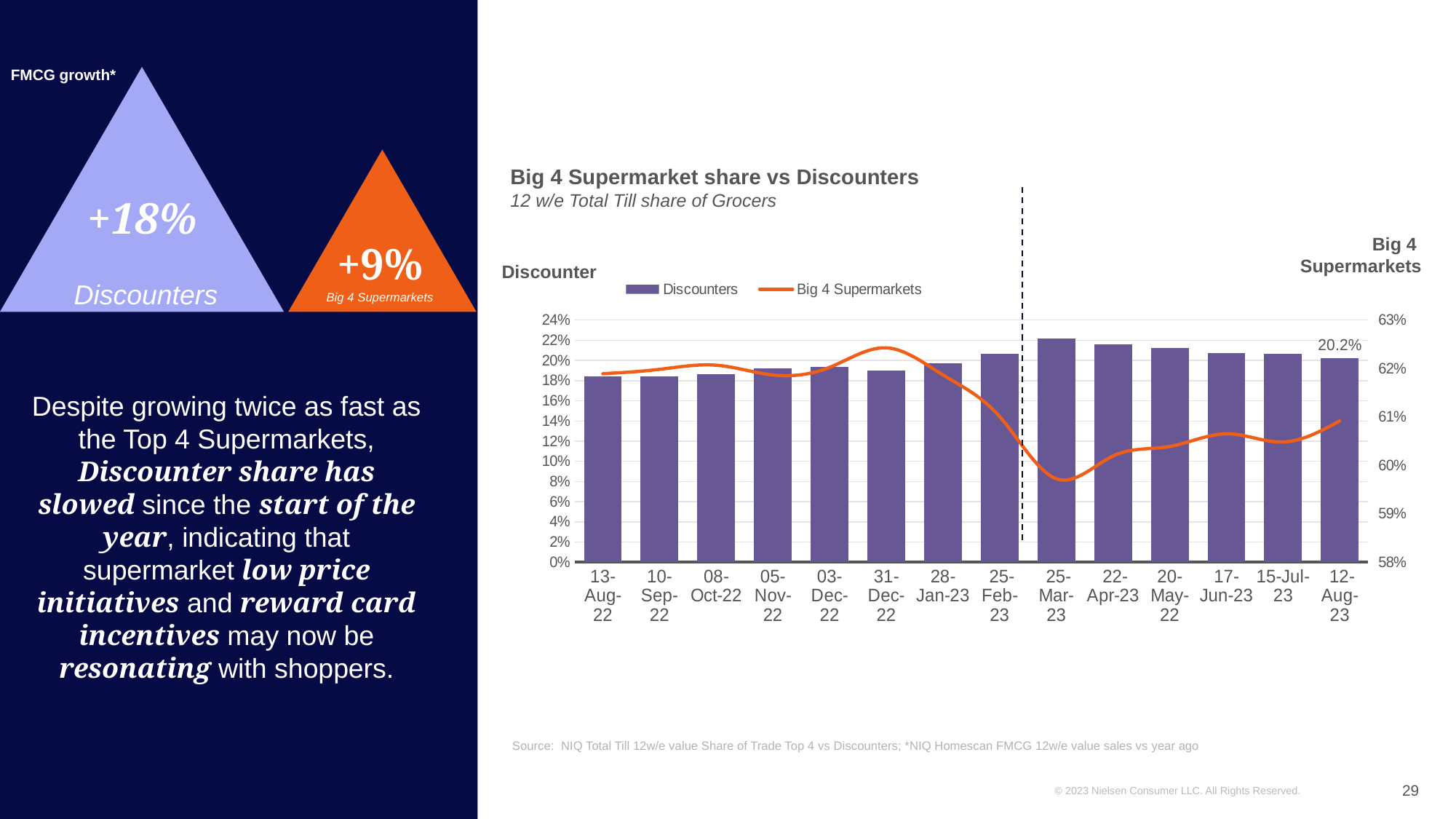
Which has the larger Discounters bar, 28-Jan-23 or 25-Feb-23? 25-Feb-23 Is the Big 4 Supermarkets value for 25-Mar-23 greater or less than 61%? less In which period is the Discounters bar highest? 25-Mar-23 How many time periods are plotted along the x axis? 14 How many series does the legend list? 2 What is the subtitle shown under the chart title? 12 w/e Total Till share of Grocers Is the Discounters value for 13-Aug-22 greater or less than 20%? less Is the Discounters value for 25-Mar-23 greater or less than 20%? greater What kind of chart is this? Combination bar and line chart What is the Discounters share shown for 12-Aug-23? 20.2% Does the Big 4 Supermarkets line rise or fall between 31-Dec-22 and 25-Mar-23? fall